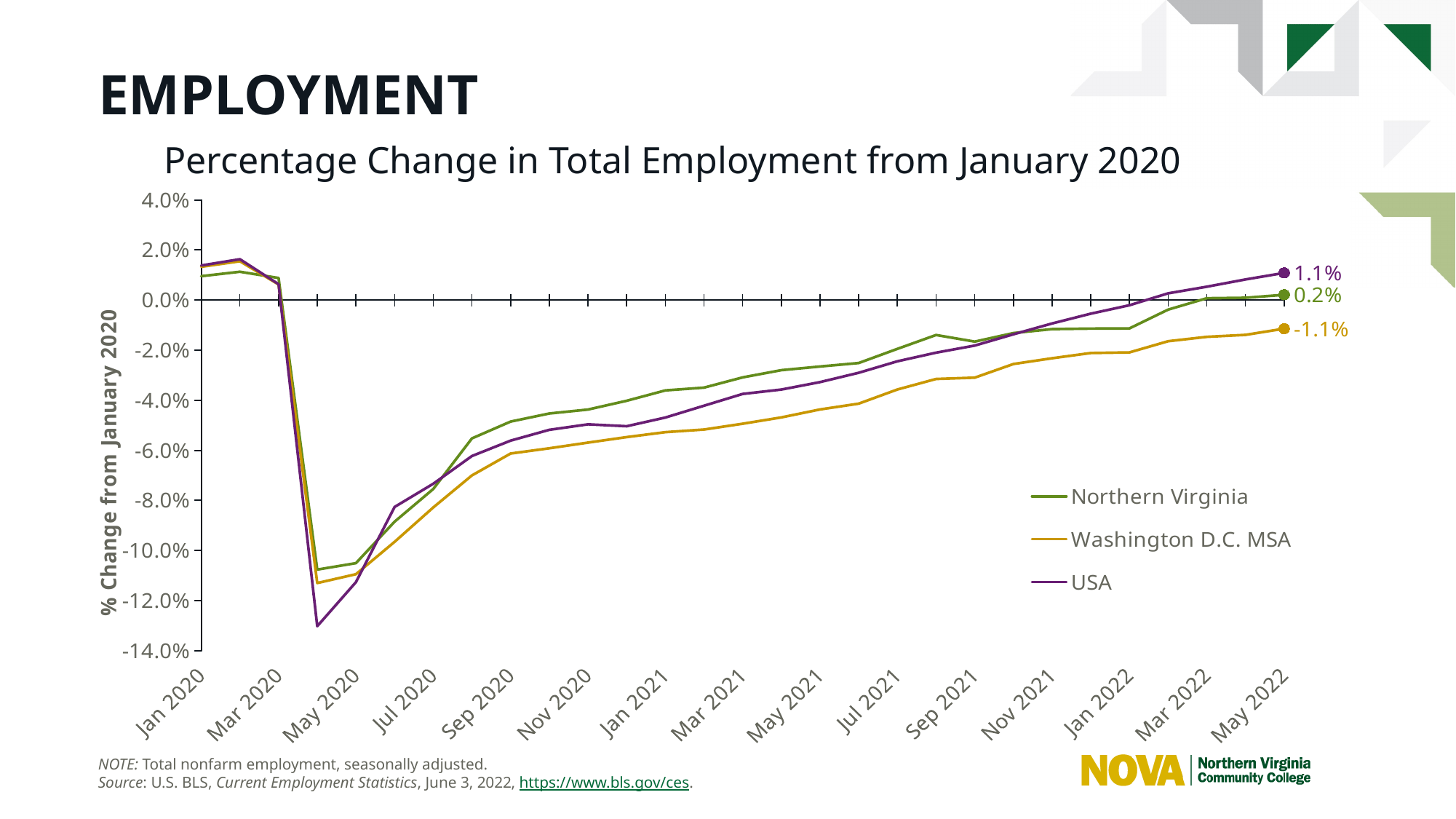
Which series has the highest value in May 2022? USA Do the values for all three series rise or fall from May 2020 to May 2022? rise What is the difference between the USA and Washington D.C. MSA values in May 2022? 2.2 percentage points In May 2022, which is larger: the value for USA or the value for Northern Virginia? USA What is the value for USA in May 2022? 1.1% What is the value for Washington D.C. MSA in May 2022? -1.1% How many series does the legend list? 3 Is the lowest point of the USA line greater or less than -12.0%? less What type of chart is shown on the slide? line chart What is the title of the chart? Percentage Change in Total Employment from January 2020 What is the value for Northern Virginia in May 2022? 0.2% Which series has the lowest value in May 2022? Washington D.C. MSA